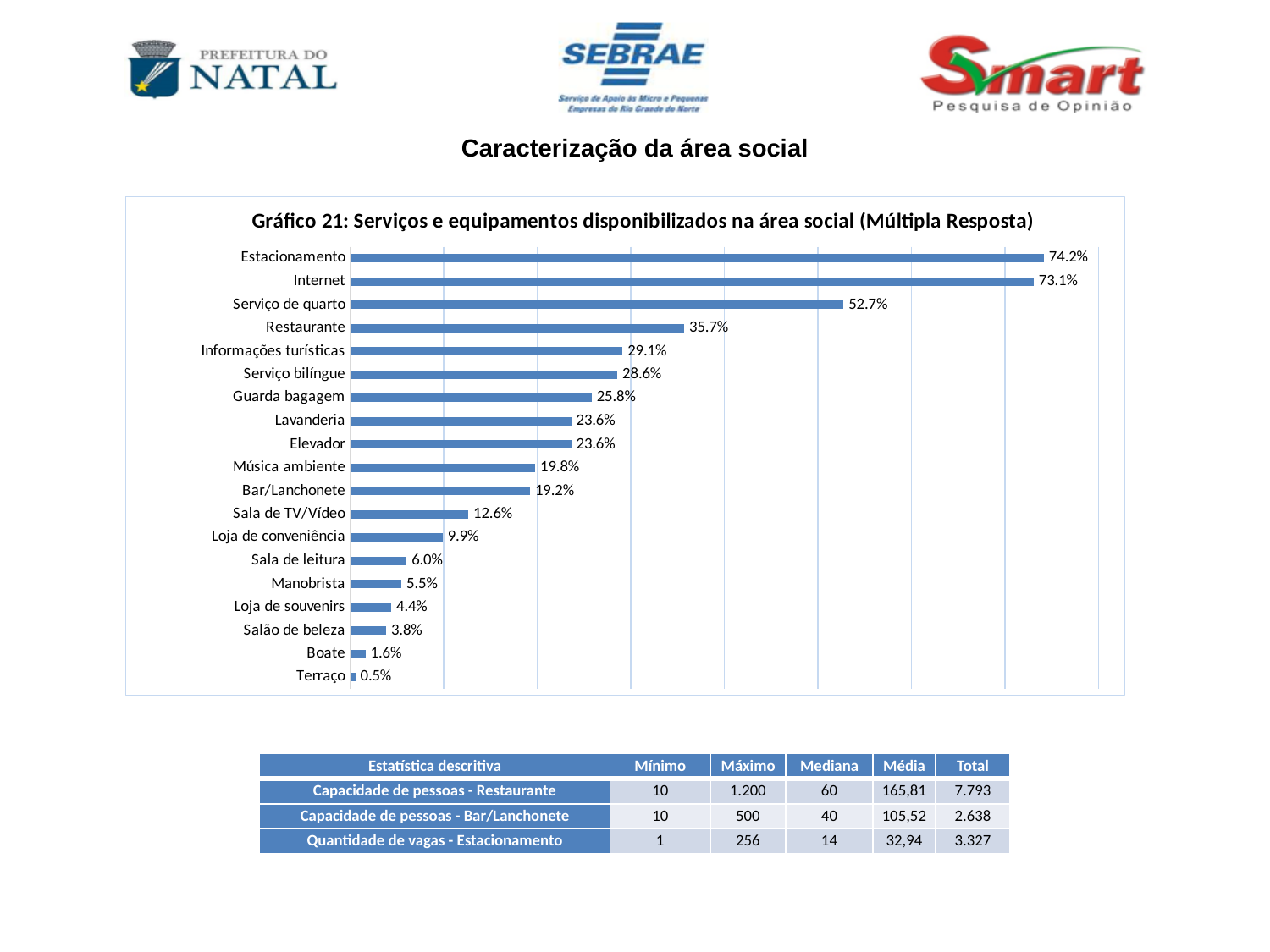
What is the difference between the values for Estacionamento and Internet? 1.1% What is the value for Estacionamento? 74.2% What is the value for Guarda bagagem? 25.8% What is the difference between the values for Restaurante and Bar/Lanchonete? 16.5% What is the value for Terraço? 0.5% How many categories are shown in the chart? 19 Which is larger, the value for Sala de TV/Vídeo or the value for Loja de conveniência? Sala de TV/Vídeo What kind of chart is Gráfico 21? bar chart What is the value for Serviço de quarto? 52.7% Which category has the highest value? Estacionamento Which category has the lowest value? Terraço What is the title of the chart? Gráfico 21: Serviços e equipamentos disponibilizados na área social (Múltipla Resposta)